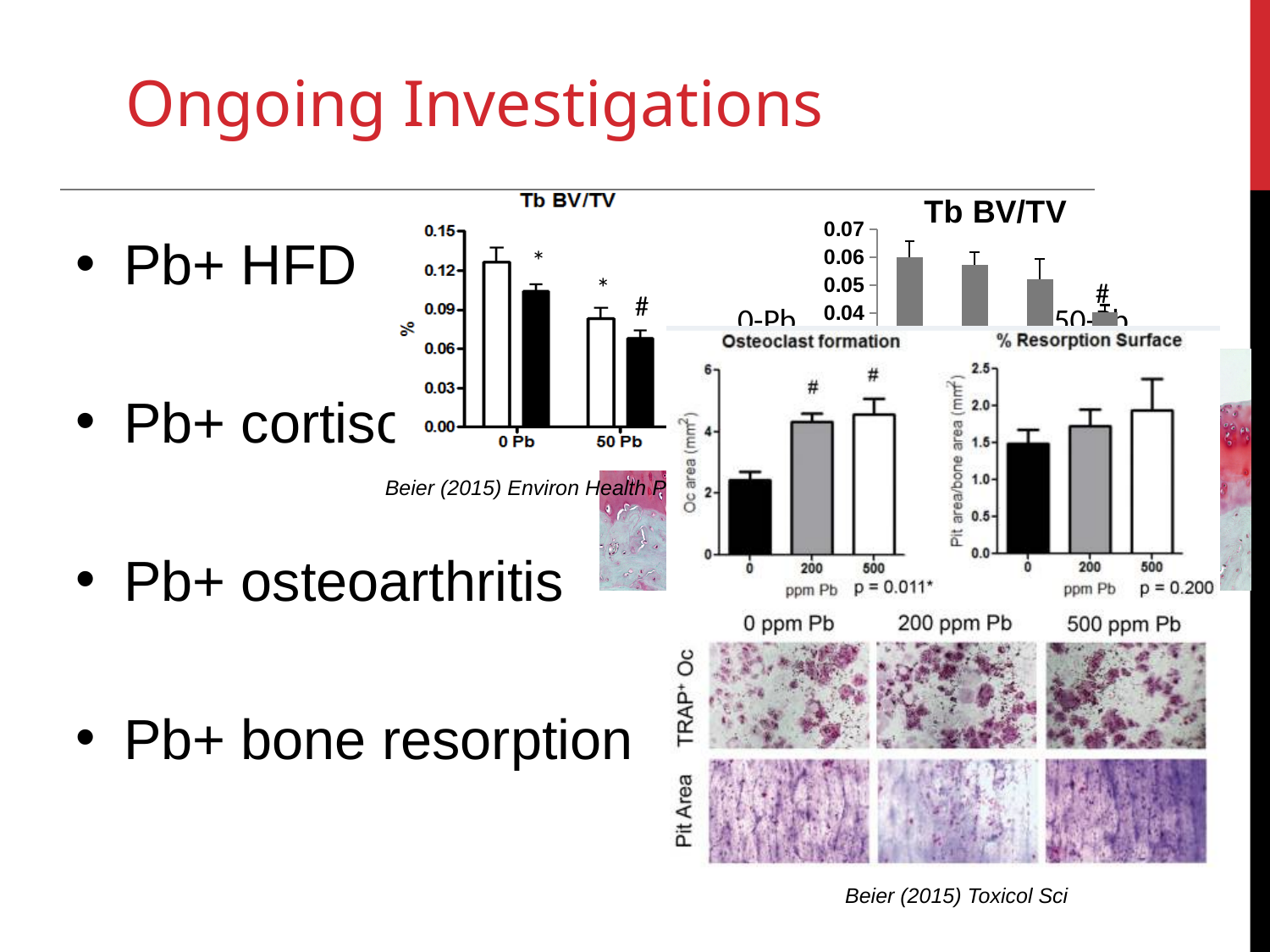
In the '% Resorption Surface' chart, is the value for 0 ppm Pb greater or less than 2.0? less In the '% Resorption Surface' chart, do the values rise or fall as ppm Pb increases from 0 to 500? rise In the 'Osteoclast formation' chart, which ppm Pb category has the lowest Oc area? 0 In the left 'Tb BV/TV' chart (with 0 Pb and 50 Pb), is the black bar for 50 Pb greater or less than 0.09? less In the 'Osteoclast formation' chart, is the Oc area for 0 ppm Pb greater or less than 4? less What p value is printed below the 'Osteoclast formation' chart? p = 0.011* What kind of chart is the 'Osteoclast formation' chart? bar chart In the 'Osteoclast formation' chart, how many ppm Pb categories are shown on the x axis? 3 What p value is printed below the '% Resorption Surface' chart? p = 0.200